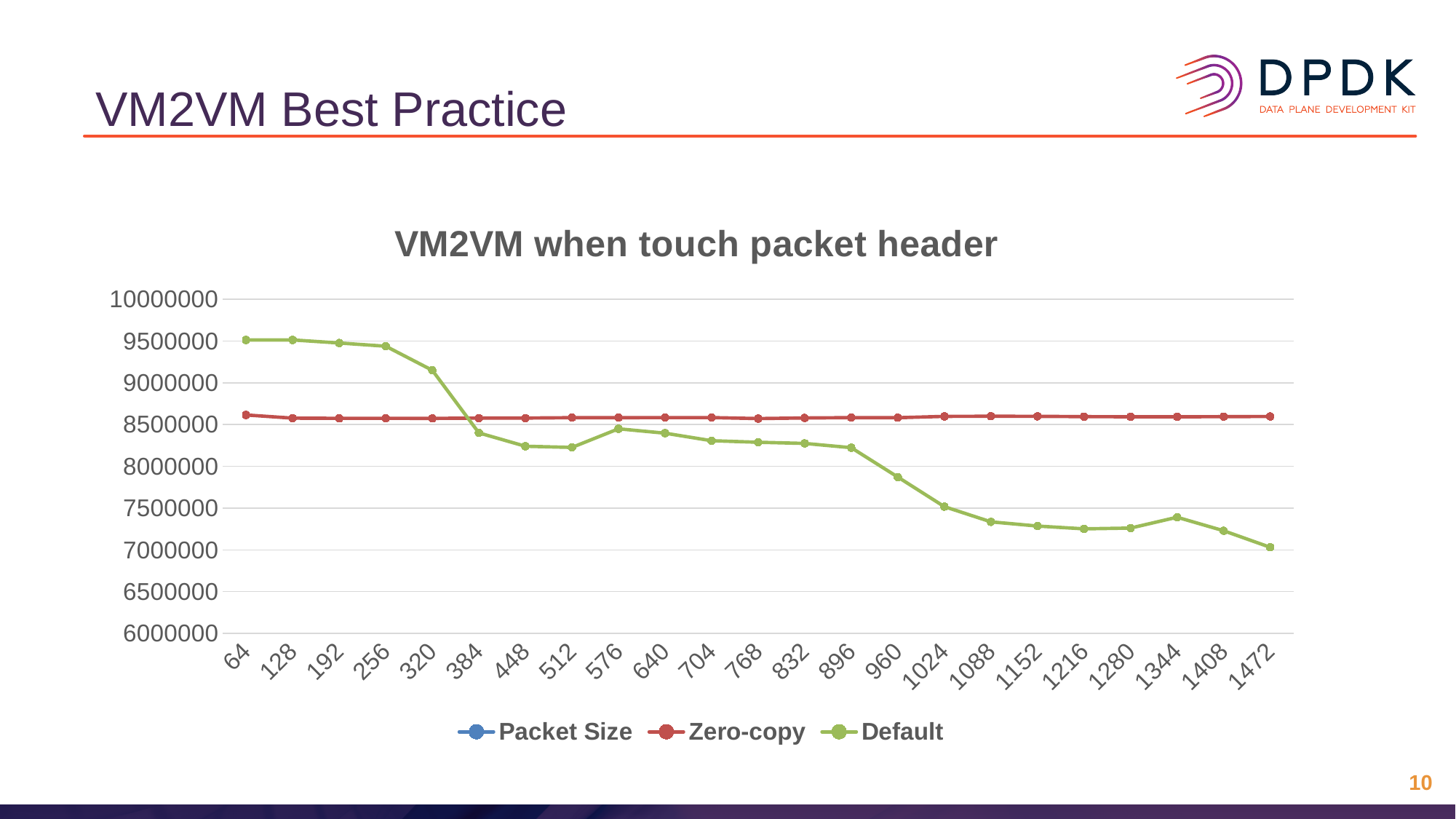
How many series does the legend list? 3 Is the Zero-copy value at packet size 64 greater or less than 8500000? greater How many packet size categories are shown on the x axis? 23 At packet size 64, which series has the higher value, Zero-copy or Default? Default What is the title of the chart? VM2VM when touch packet header Is the Default value at packet size 1472 greater or less than 7500000? less Is the Default value at packet size 64 greater or less than 9000000? greater At packet size 1472, which series has the higher value, Zero-copy or Default? Zero-copy Does the Default series rise or fall as packet size increases along the x axis? fall At which packet size is the Default series lowest? 1472 What kind of chart is shown on the slide? line chart